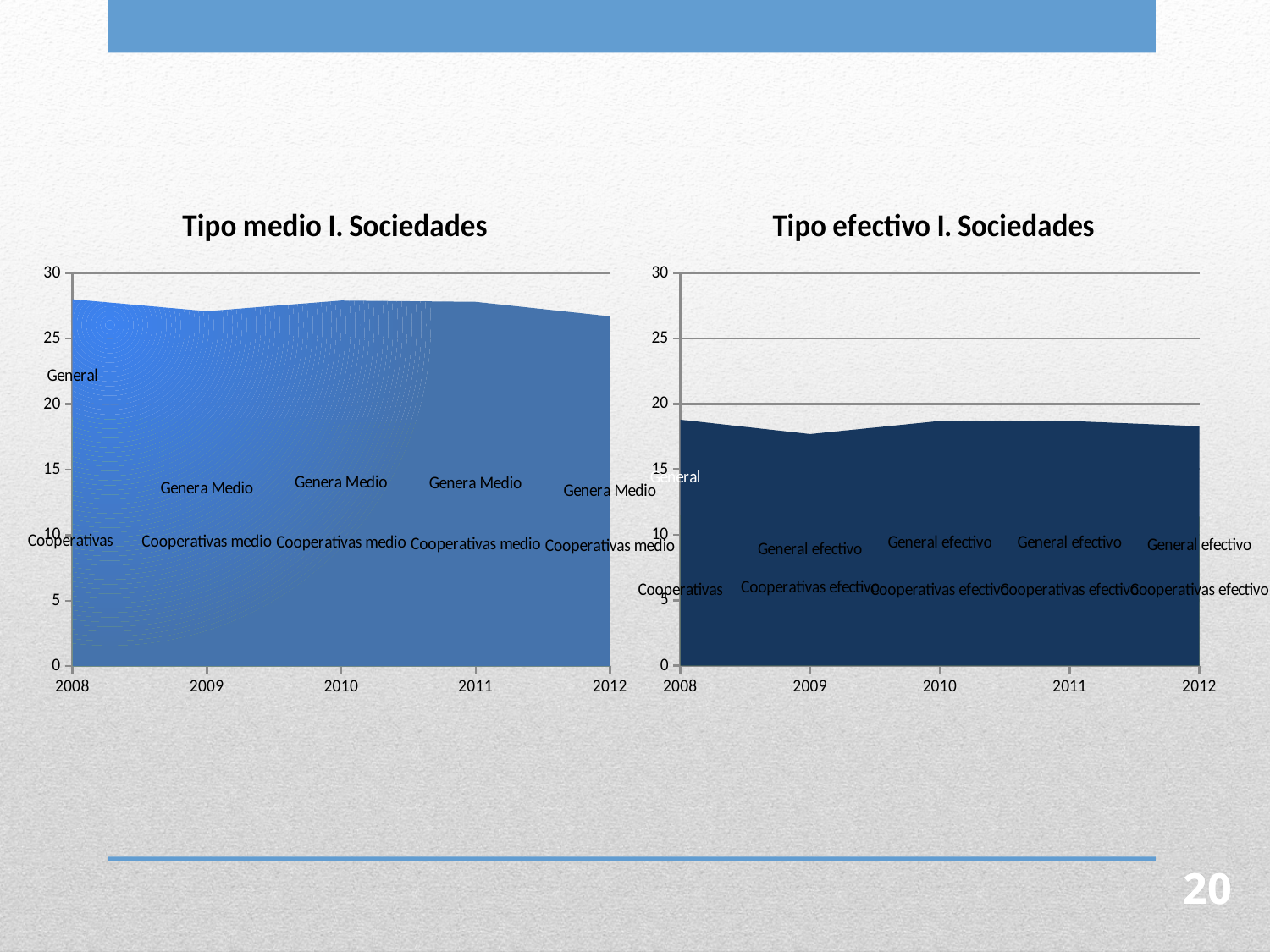
How many years are shown on the x axis of the 'Tipo efectivo I. Sociedades' chart? 5 In the 'Tipo efectivo I. Sociedades' chart, does the value rise or fall from 2008 to 2009? fall In the 'Tipo medio I. Sociedades' chart, is the value for 2012 greater or less than 25? greater In the 'Tipo efectivo I. Sociedades' chart, which year has the lowest value? 2009 Which chart shows a higher value for 2008, 'Tipo medio I. Sociedades' or 'Tipo efectivo I. Sociedades'? Tipo medio I. Sociedades In the 'Tipo efectivo I. Sociedades' chart, is the value for 2008 greater or less than 20? less What is the first year shown on the x axis of the 'Tipo medio I. Sociedades' chart? 2008 In the 'Tipo medio I. Sociedades' chart, is the value for 2008 greater or less than 25? greater What kind of chart is the 'Tipo medio I. Sociedades' chart? area chart In the 'Tipo medio I. Sociedades' chart, does the value rise or fall from 2009 to 2010? rise What is the title of the chart on the right side of the slide? Tipo efectivo I. Sociedades